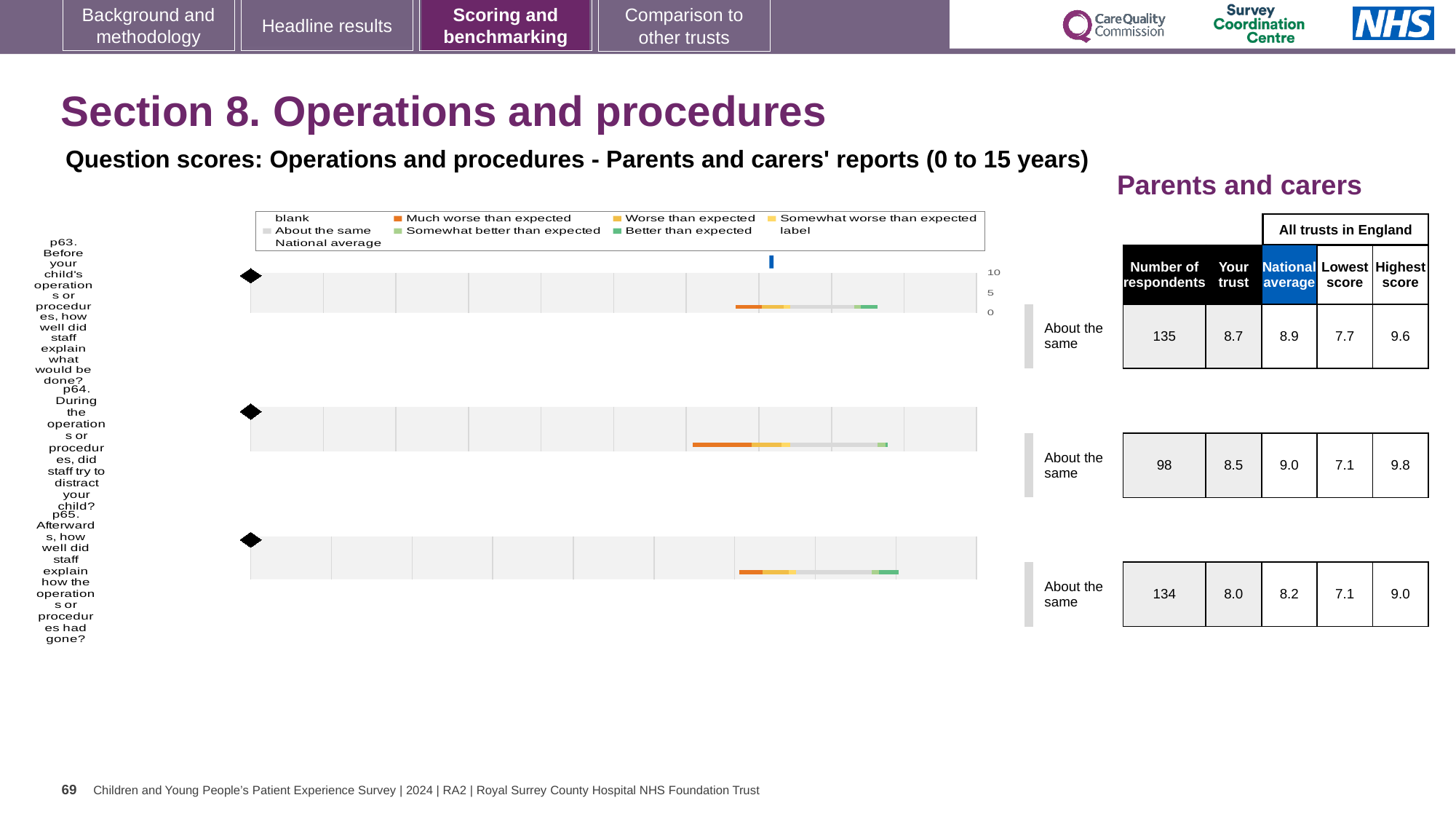
What is the highest score among all trusts in England for p63? 9.6 For p64, which is larger: the 'Your trust' score or the national average? National average What is the national average score for p64 (did staff try to distract your child during the operation)? 9.0 What kind of chart is used to show the question scores on this slide? bar chart How many respondents answered p65 (how well staff explained how the operation had gone)? 134 What is the difference between the national average and the 'Your trust' score for p63? 0.2 How many questions (p63, p64, p65) are plotted in the chart? 3 Which of the three questions has the highest 'Your trust' score? p63 What is the 'Your trust' score for p63 (how well staff explained what would be done before the operation)? 8.7 How many entries does the chart legend list? 9 Which of the three questions has the lowest 'Your trust' score? p65 What benchmark label is shown next to each of the three questions? About the same